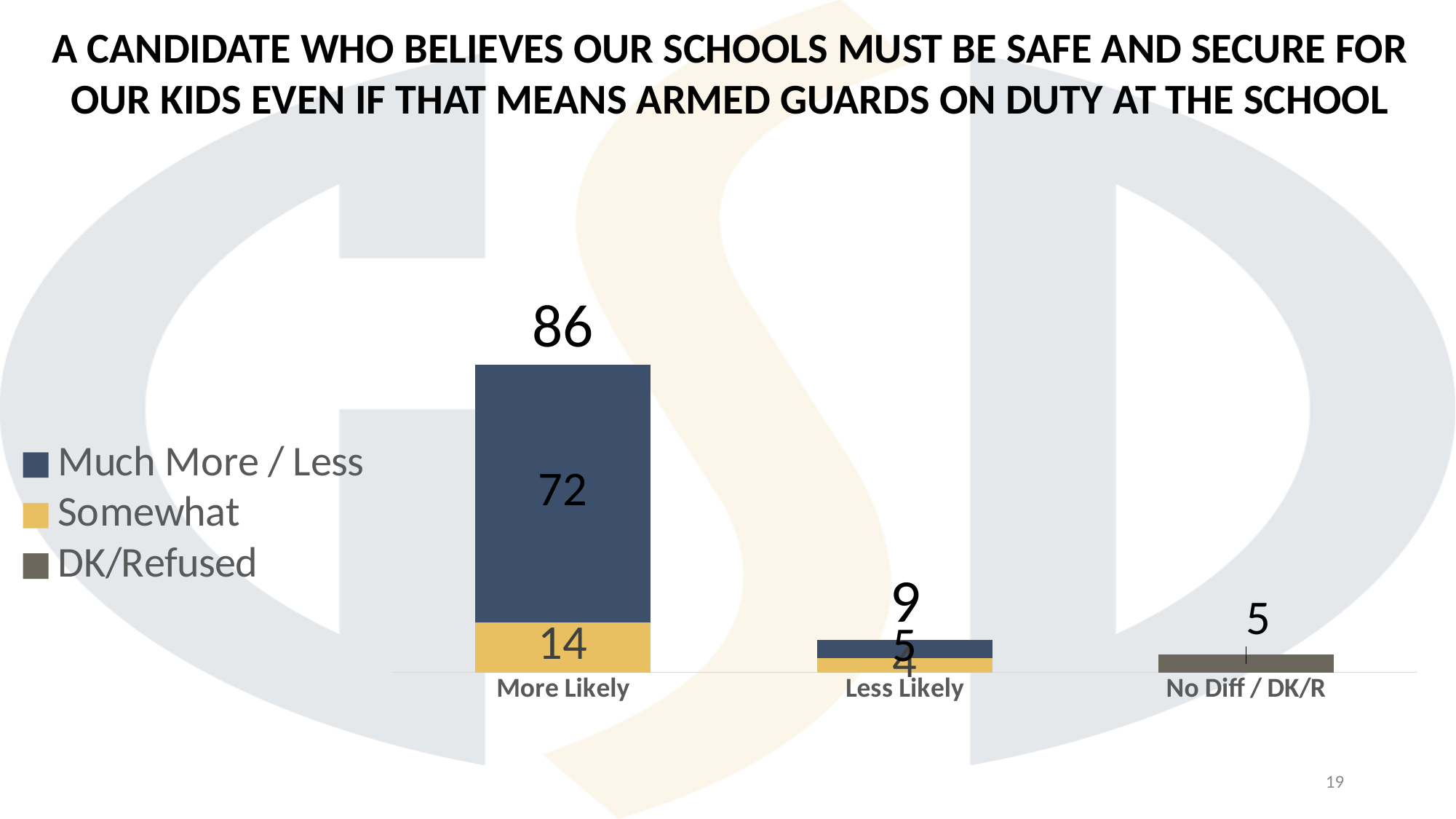
What is the Much More / Less value for Less Likely? 5 What is the Somewhat value for Less Likely? 4 What is the total of the stacked bar for More Likely? 86 Which is larger: the Somewhat value for More Likely or the Somewhat value for Less Likely? More Likely What is the Much More / Less value for More Likely? 72 What is the total of the stacked bar for Less Likely? 9 How many series does the legend list? 3 What is the difference between the Much More / Less value for More Likely and the Much More / Less value for Less Likely? 67 Which category has the highest total? More Likely How many categories are shown on the x axis? 3 What is the value for No Diff / DK/R? 5 What is the Somewhat value for More Likely? 14